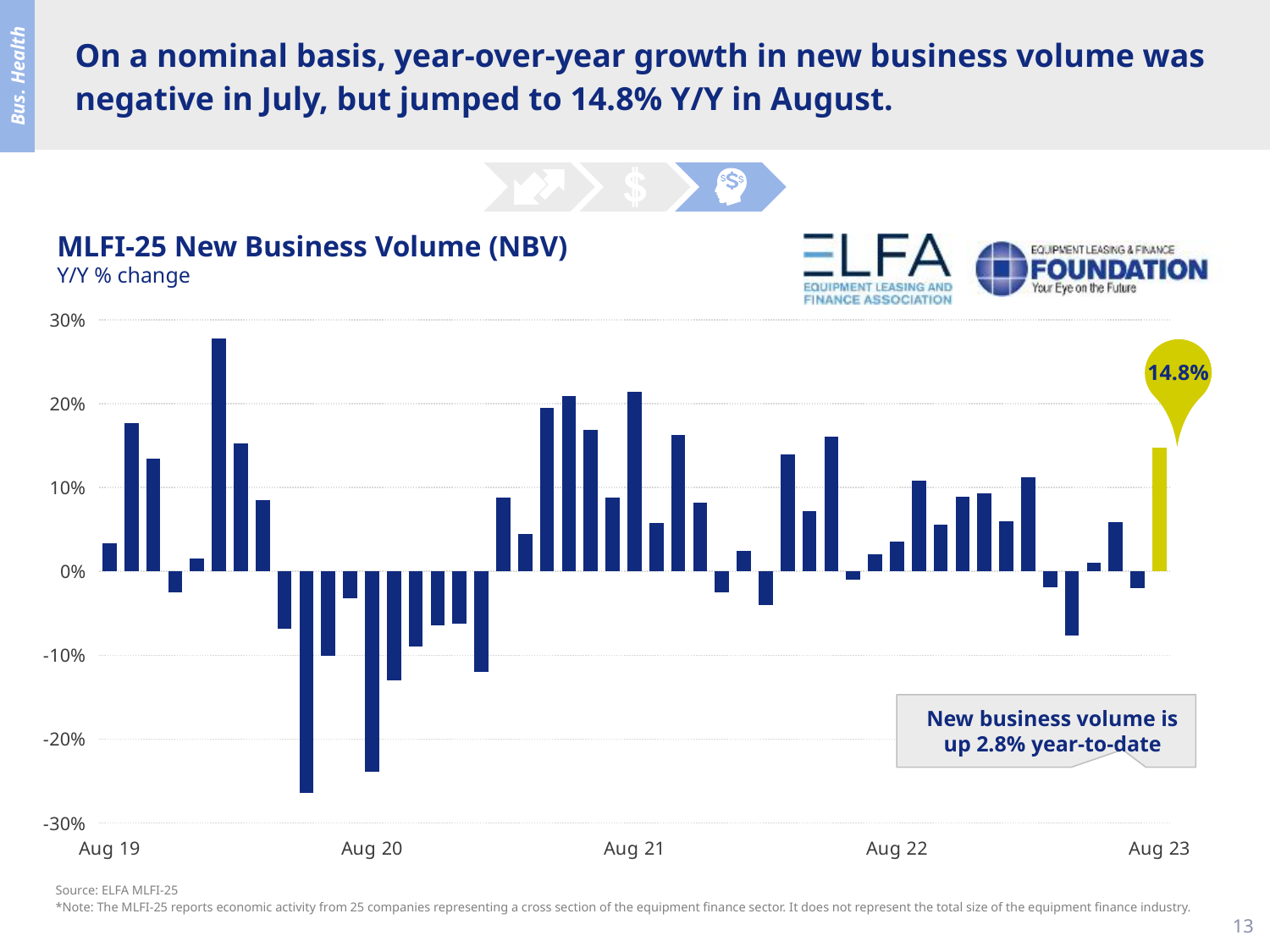
Is the lowest bar on the chart greater or less than -20%? less Is the value for Aug 21 greater or less than 0%? greater Is the value for Aug 23 greater or less than 10%? greater What is the title of the chart? MLFI-25 New Business Volume (NBV) How many labels are shown on the x axis of the chart? 5 According to the callout box on the chart, by how much is new business volume up year-to-date? 2.8% Which has the larger Y/Y % change, Aug 19 or Aug 23? Aug 23 What is the Y/Y % change in new business volume for Aug 23? 14.8% What kind of chart is used to show the MLFI-25 New Business Volume data? Bar chart